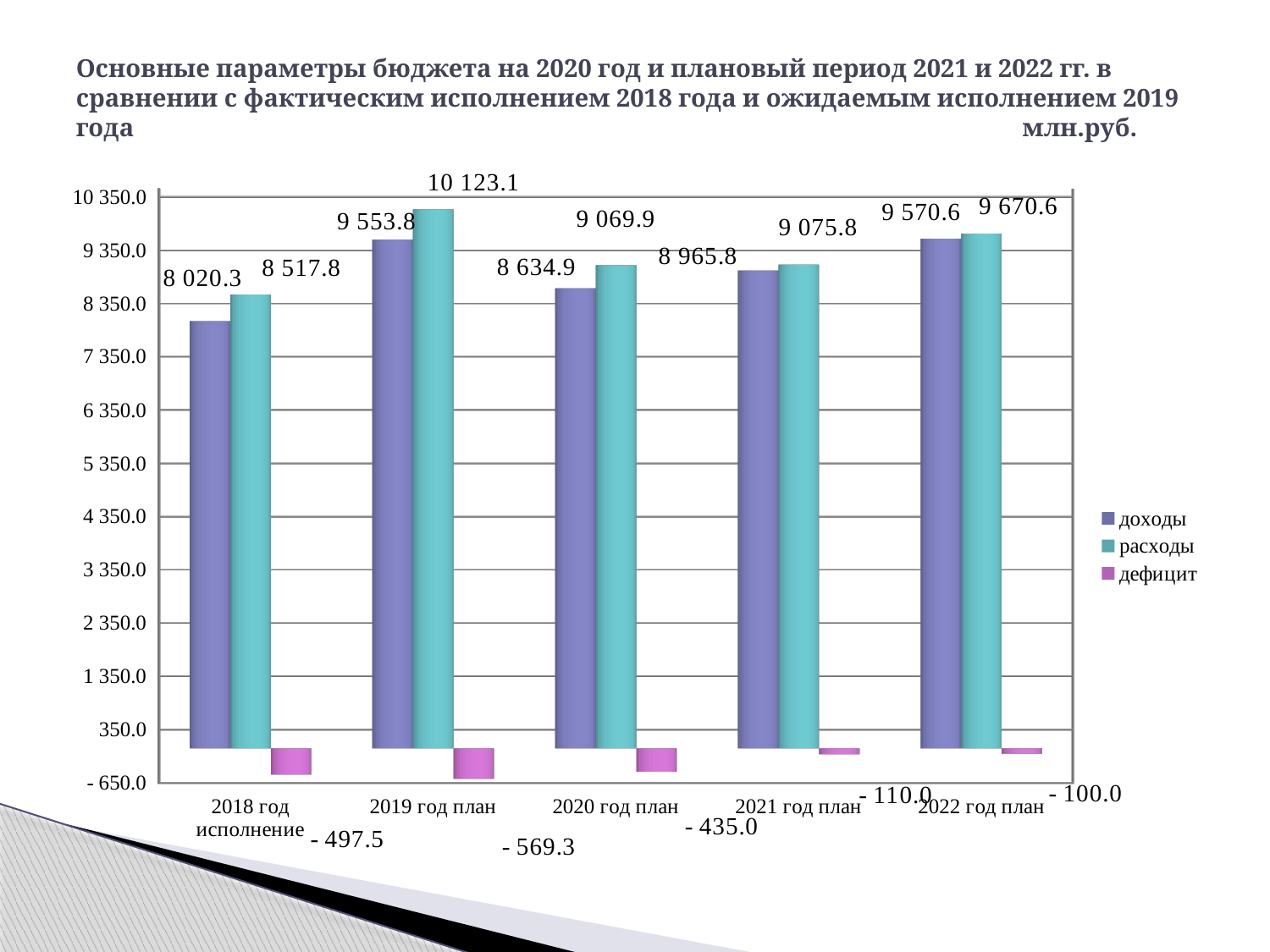
How many year categories are shown on the x axis? 5 What is the value of доходы for 2018 год исполнение? 8 020.3 Is the value of доходы for 2021 год план greater or less than 8 350.0? greater What is the value of доходы for 2022 год план? 9 570.6 Which is larger for 2020 год план: доходы or расходы? расходы What is the value of дефицит for 2020 год план? - 435.0 In which year are расходы the highest? 2019 год план How many series does the legend list? 3 What is the difference between расходы and доходы for 2021 год план? 110.0 In which year are доходы the lowest? 2018 год исполнение What is the value of расходы for 2019 год план? 10 123.1 What kind of chart is shown on the slide? bar chart